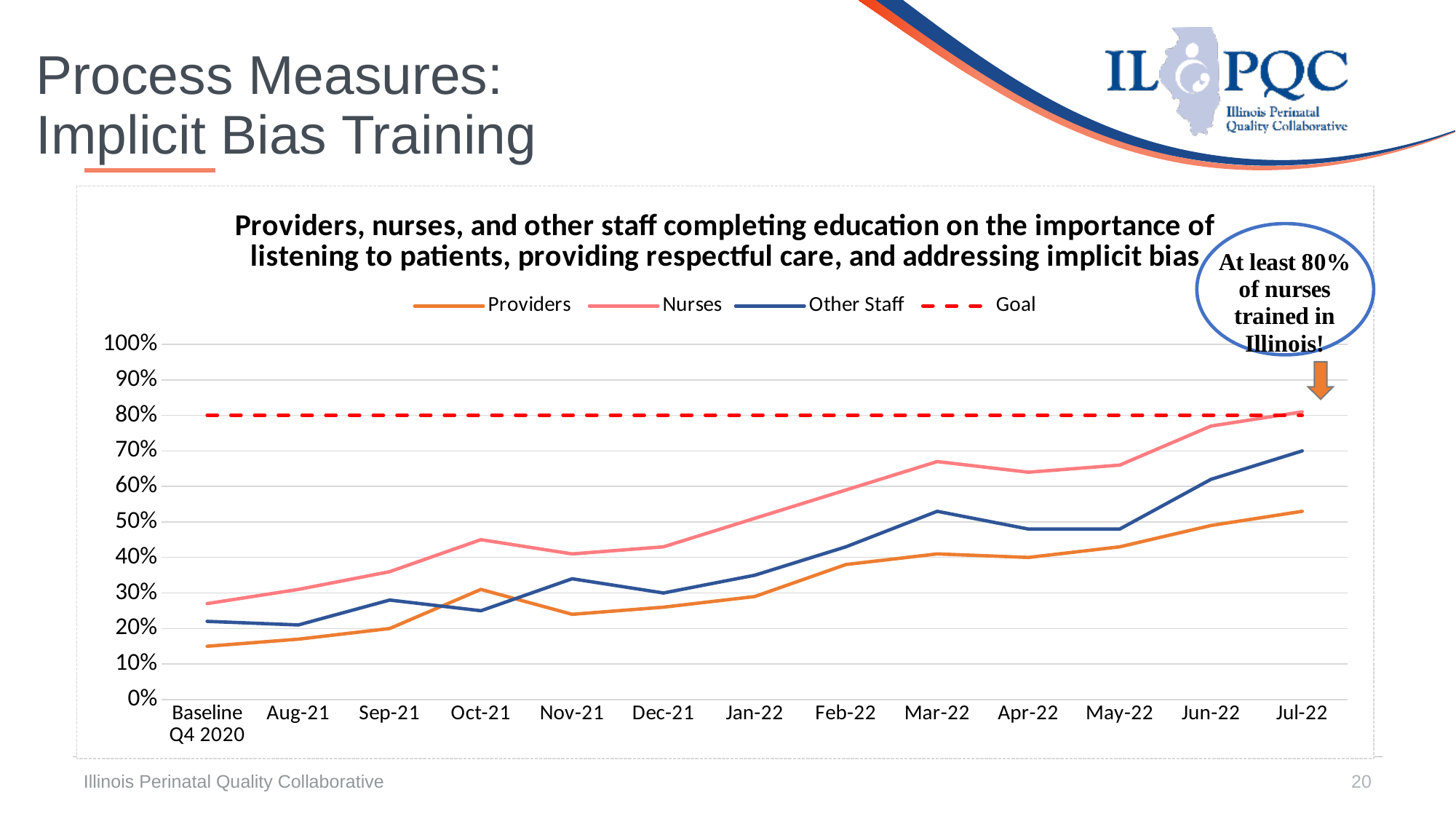
What kind of chart is shown on the slide? line chart Is the value for Other Staff at Nov-21 greater or less than 30%? greater Does the Nurses line rise or fall from Baseline Q4 2020 to Jul-22? rise At Jul-22, which series has the highest value? Nurses At Baseline Q4 2020, which series has the lowest value? Providers Is the value for Nurses at Mar-22 greater or less than 60%? greater Is the value for Providers at Baseline Q4 2020 greater or less than 20%? less How many time points are shown along the x axis? 13 What value does the dashed Goal line sit at? 80% At Nov-21, which is larger: Other Staff or Providers? Other Staff How many series does the legend list? 4